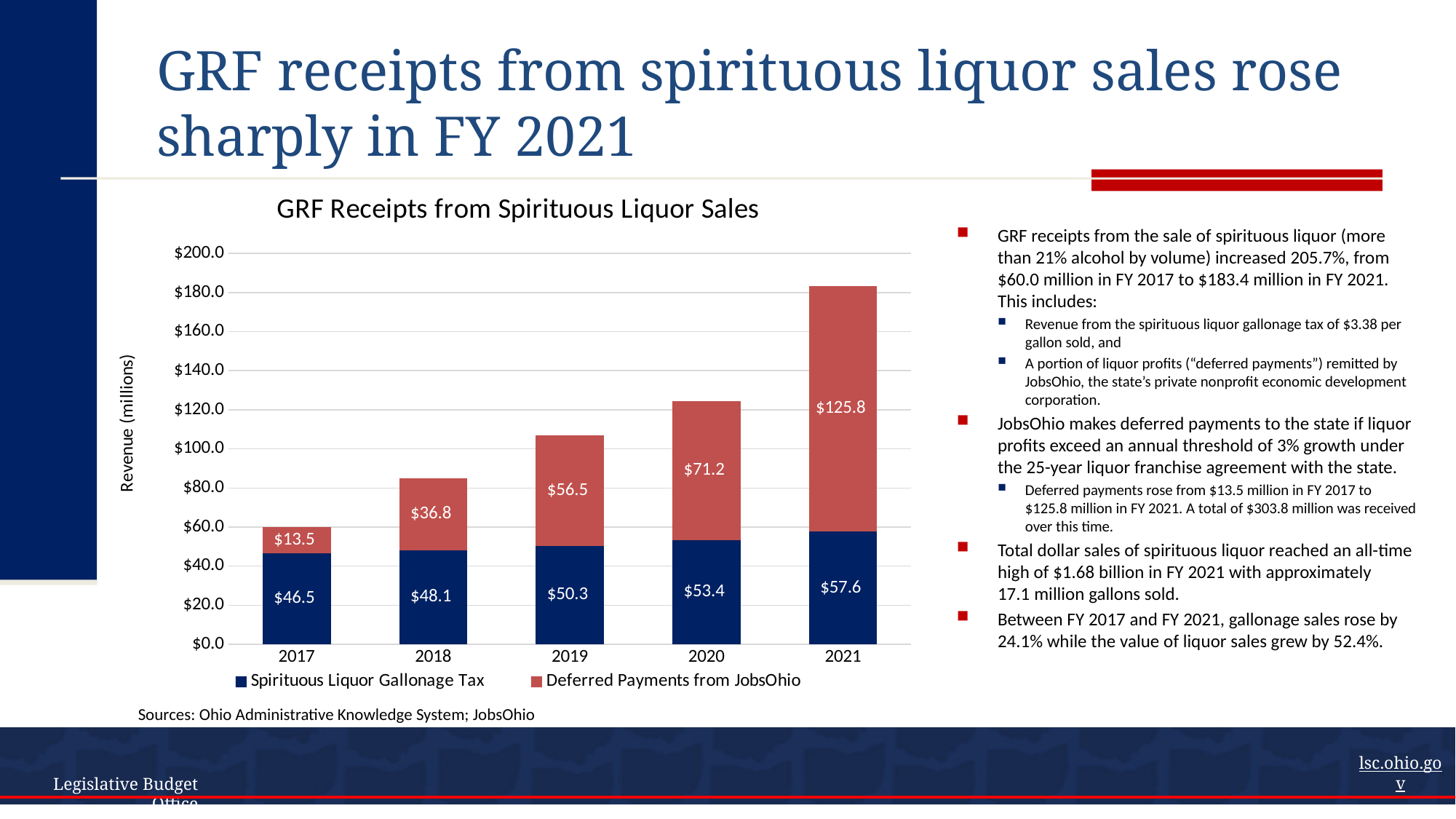
What is the value of Deferred Payments from JobsOhio in 2021? $125.8 What is the total of the stacked bar for 2020? $124.6 What is the value of Deferred Payments from JobsOhio in 2019? $56.5 How many years are shown on the x axis? 5 What type of chart is shown on the slide? Stacked bar chart What is the value of the Spirituous Liquor Gallonage Tax in 2017? $46.5 Do the Deferred Payments from JobsOhio rise or fall from 2017 to 2021? Rise What is the difference between the Spirituous Liquor Gallonage Tax in 2021 and in 2017? $11.1 Which year has the highest Deferred Payments from JobsOhio? 2021 How many series does the legend list? 2 Which is larger in 2018: the Spirituous Liquor Gallonage Tax or Deferred Payments from JobsOhio? Spirituous Liquor Gallonage Tax Which year has the lowest Spirituous Liquor Gallonage Tax? 2017